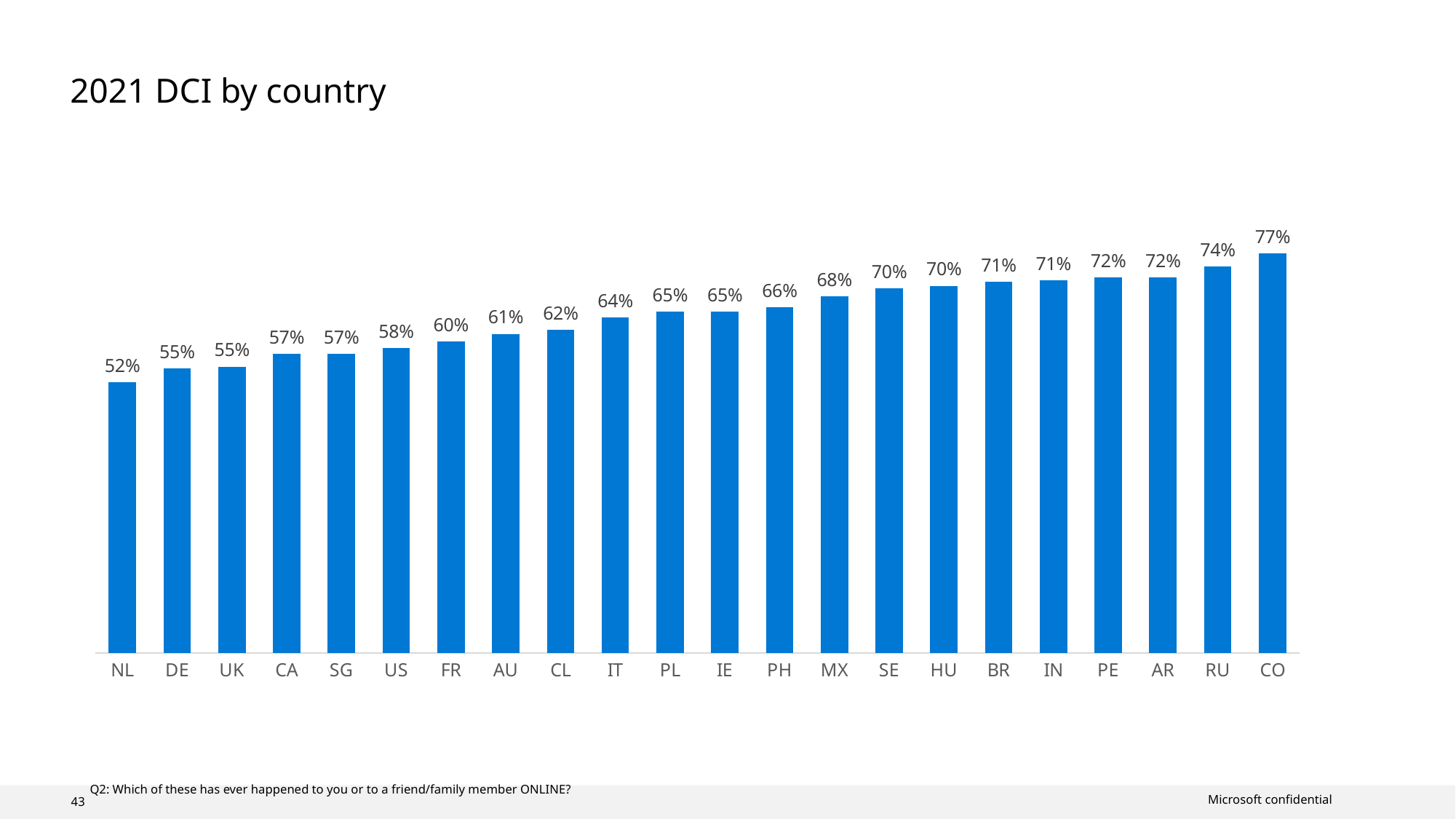
What is the difference between the DCI values for IN and FR? 11% What is the title of the chart? 2021 DCI by country What type of chart is shown on the slide? Bar chart Which has a higher DCI value, PH or CA? PH What is the 2021 DCI value for MX? 68% Which country has the highest 2021 DCI value? CO Do the DCI values rise or fall from left to right across the countries? Rise How many countries are shown in the chart? 22 What is the 2021 DCI value for the US? 58% What is the difference between the DCI values for CO and NL? 25% Which country has the lowest 2021 DCI value? NL What is the 2021 DCI value for RU? 74%